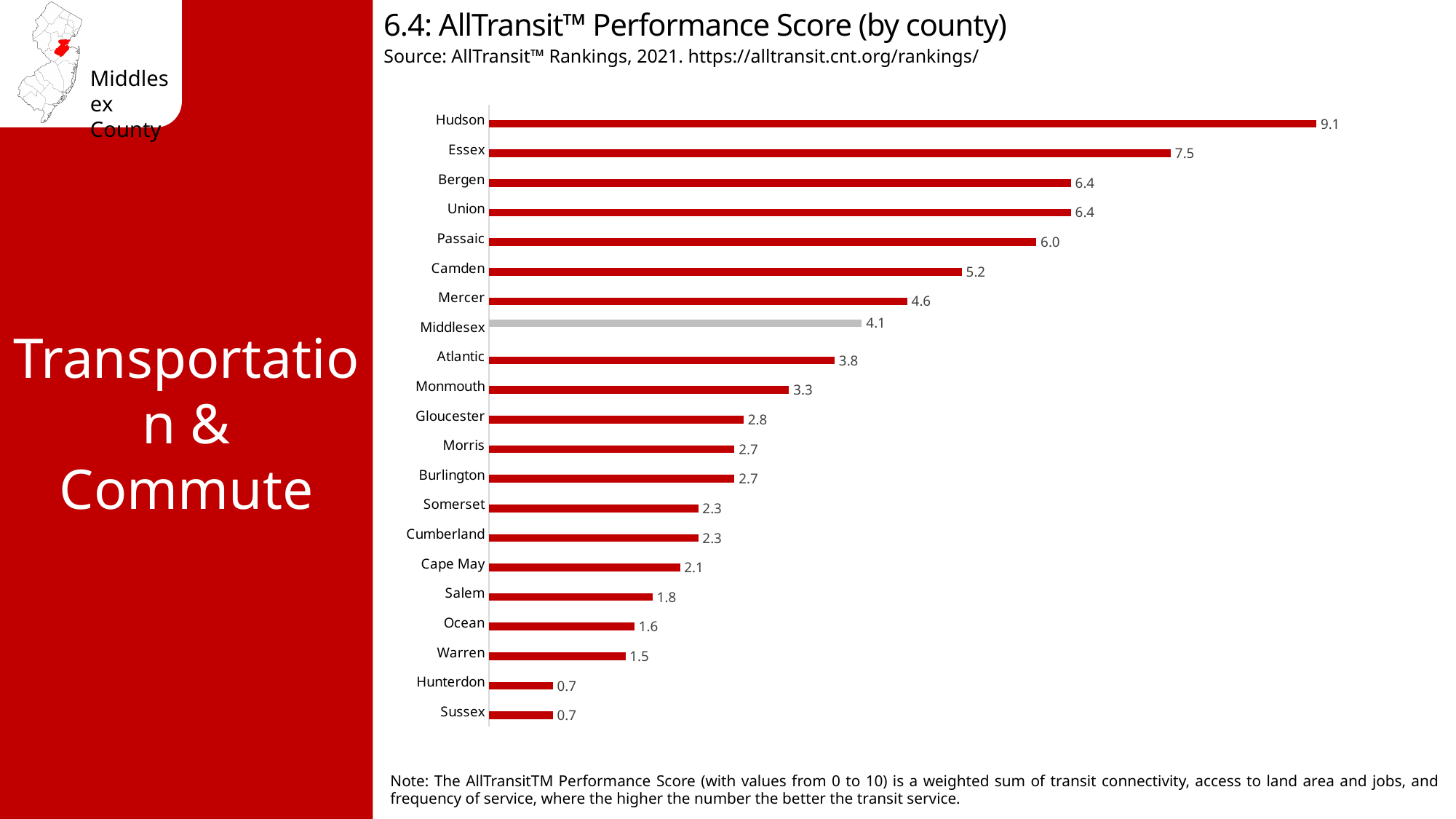
What is the AllTransit Performance Score for Camden? 5.2 What is the AllTransit Performance Score for Hudson? 9.1 What is the AllTransit Performance Score for Middlesex? 4.1 Which has a higher score, Passaic or Camden? Passaic What is the difference between the scores of Mercer and Middlesex? 0.5 What is the difference between the scores of Hudson and Essex? 1.6 What is the title of the chart? 6.4: AllTransit™ Performance Score (by county) Which county's bar is shown in grey rather than red? Middlesex Which has a higher score, Monmouth or Atlantic? Atlantic Which county has the highest AllTransit Performance Score? Hudson What kind of chart is shown on the slide? Bar chart How many counties are shown in the chart? 21